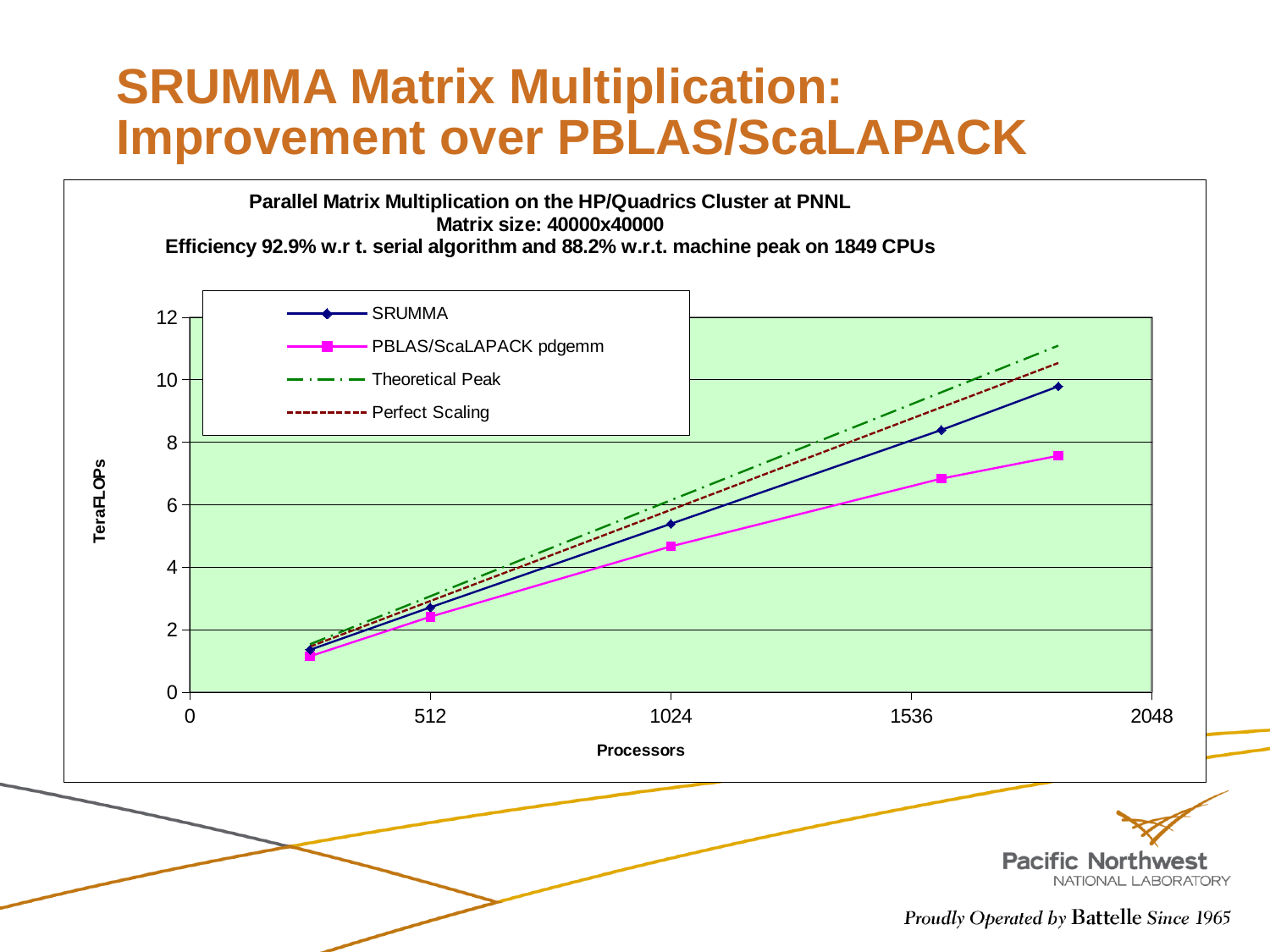
What kind of chart is shown on the slide? line chart Is the SRUMMA value at its rightmost point greater or less than 8 TeraFLOPs? greater Is the PBLAS/ScaLAPACK pdgemm value at its rightmost point greater or less than 8 TeraFLOPs? less Is the SRUMMA value at 1024 processors greater or less than 6 TeraFLOPs? less Which series has the lowest value at the right end of the chart? PBLAS/ScaLAPACK pdgemm How many data points are plotted for the SRUMMA series? 5 How many series does the legend list? 4 At 1024 processors, which is larger: SRUMMA or PBLAS/ScaLAPACK pdgemm? SRUMMA What is the label of the x axis? Processors What is the label of the y axis? TeraFLOPs Do the SRUMMA values rise or fall as the number of processors increases? rise